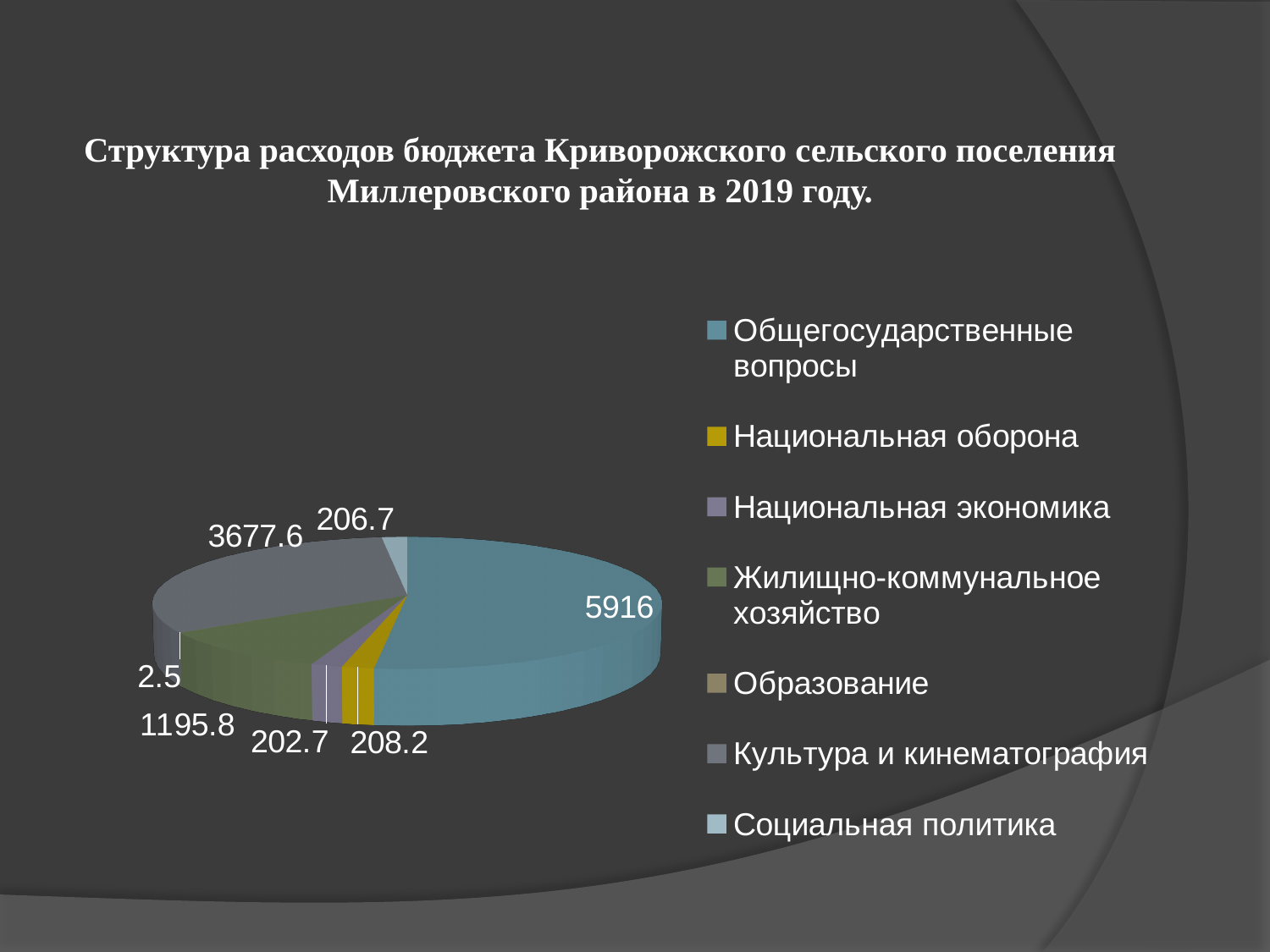
Which is larger, the value for Национальная оборона or the value for Социальная политика? Национальная оборона What is the title of the slide containing the chart? Структура расходов бюджета Криворожского сельского поселения Миллеровского района в 2019 году. Which category has the smallest slice of the pie? Образование How many categories does the legend list? 7 What is the value for Культура и кинематография? 3677.6 What is the value for Национальная оборона? 208.2 What kind of chart is shown on the slide? pie chart What is the value for Общегосударственные вопросы? 5916 What is the difference between the values for Общегосударственные вопросы and Культура и кинематография? 2238.4 Which category has the largest slice of the pie? Общегосударственные вопросы What is the value for Образование? 2.5 What is the value for Жилищно-коммунальное хозяйство? 1195.8